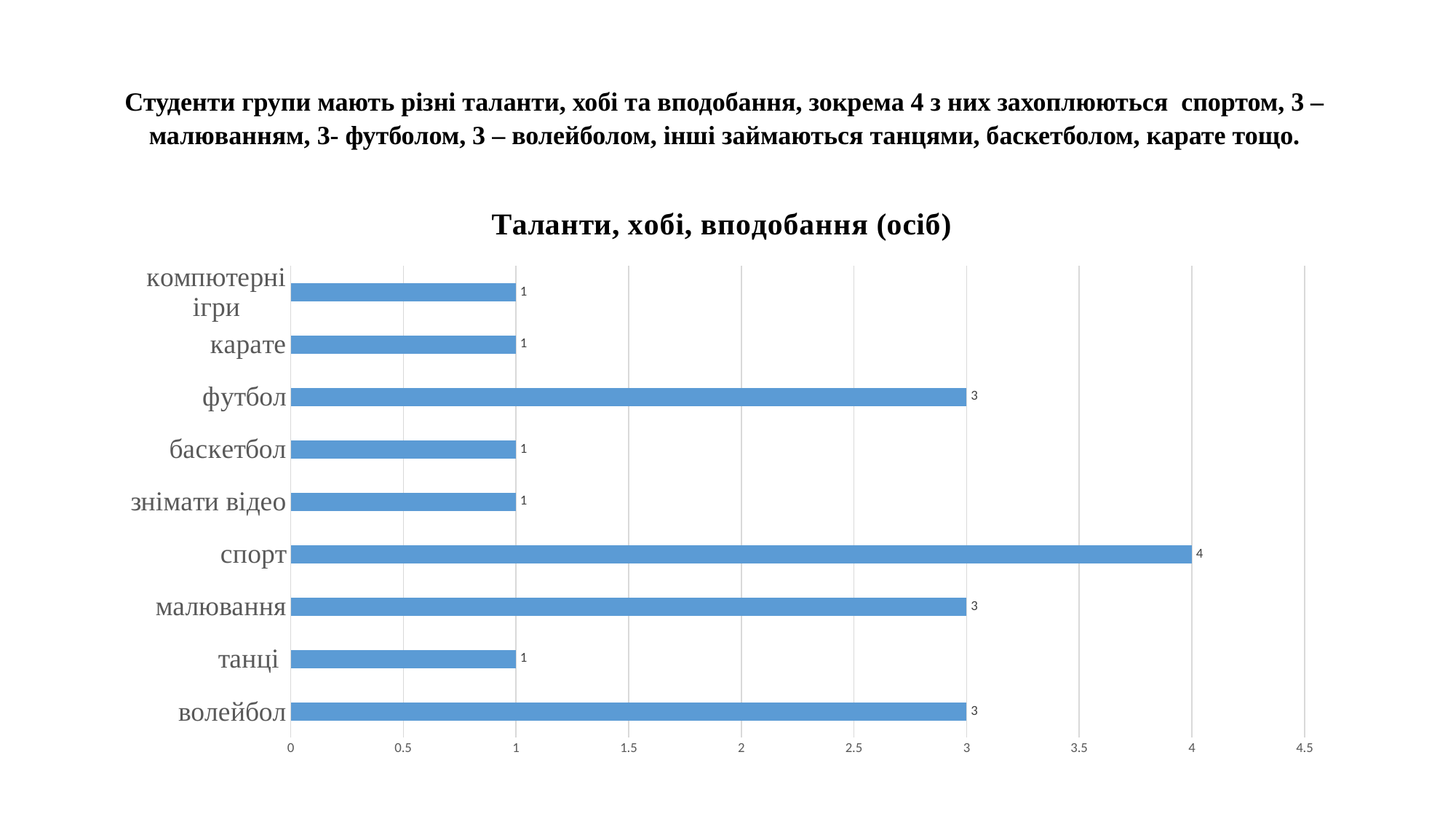
What is the value for спорт? 4 What is the value for футбол? 3 Which is larger, the value for футбол or the value for баскетбол? футбол Which category has the highest value? спорт What is the value for танці? 1 What kind of chart is this? bar chart What is the difference between the values for спорт and волейбол? 1 What is the title of the chart? Таланти, хобі, вподобання (осіб) Is the value for малювання greater or less than 2? greater How many categories are shown in the chart? 9 What is the value for малювання? 3 How many categories have a value of 1? 5